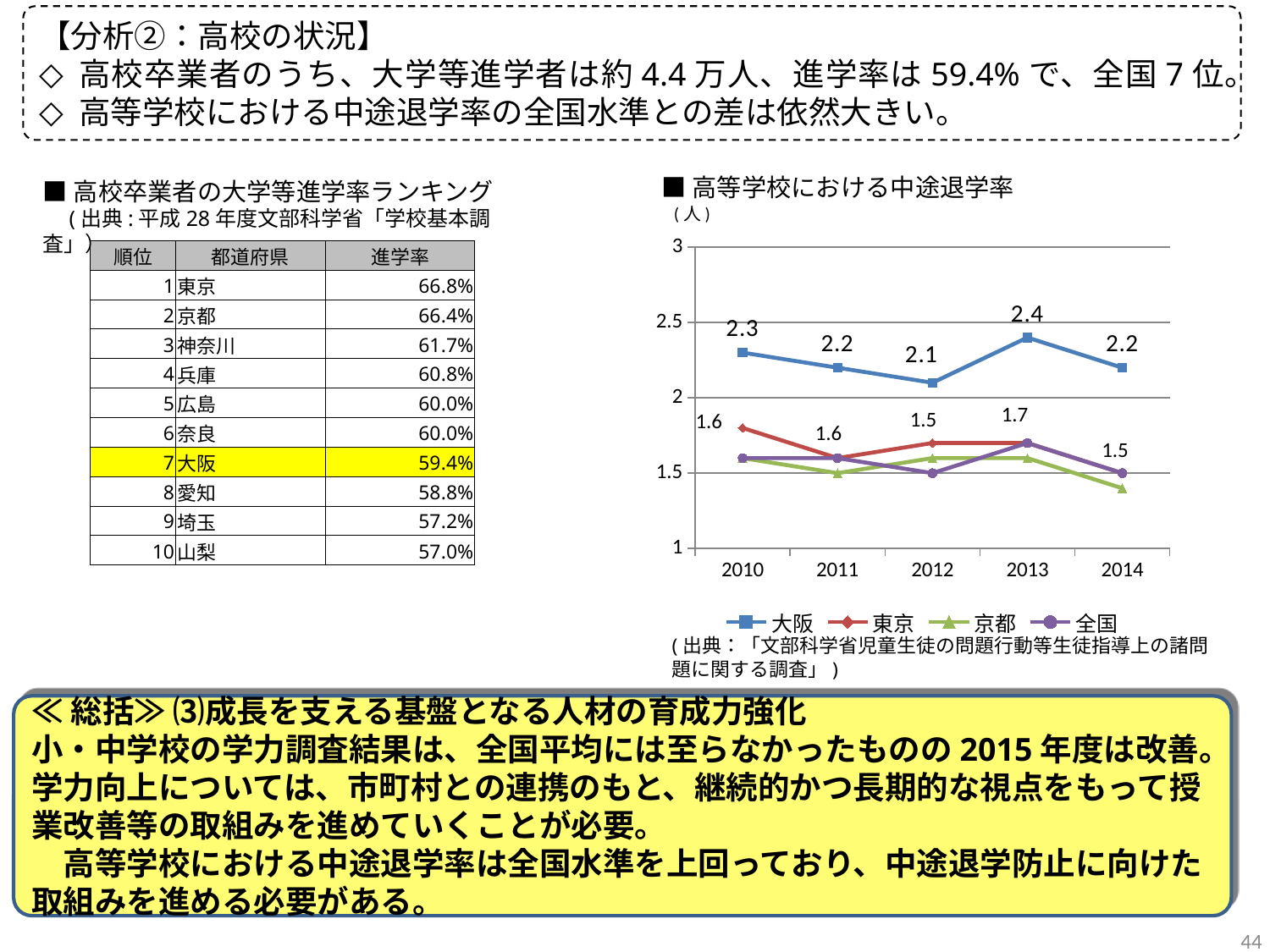
In the 高等学校における中途退学率 chart, what is the value for 大阪 in 2013? 2.4 In the 高等学校における中途退学率 chart, what is the value for 大阪 in 2012? 2.1 In the 高等学校における中途退学率 chart, is the value for 京都 in 2014 greater or less than 2? less How many series does the legend of the 高等学校における中途退学率 chart list? 4 In the 高等学校における中途退学率 chart, what is the difference between the 大阪 values for 2013 and 2012? 0.3 What kind of chart is the 高等学校における中途退学率 chart? line chart In the 高等学校における中途退学率 chart, in which year is the 大阪 value lowest? 2012 How many years are shown on the x axis of the 高等学校における中途退学率 chart? 5 In the 高等学校における中途退学率 chart, in which year is the 大阪 value highest? 2013 In the 高等学校における中途退学率 chart, which series has the highest values across all years? 大阪 In the 高等学校における中途退学率 chart, which series is drawn in blue? 大阪 In the 高等学校における中途退学率 chart, what is the value for 大阪 in 2010? 2.3